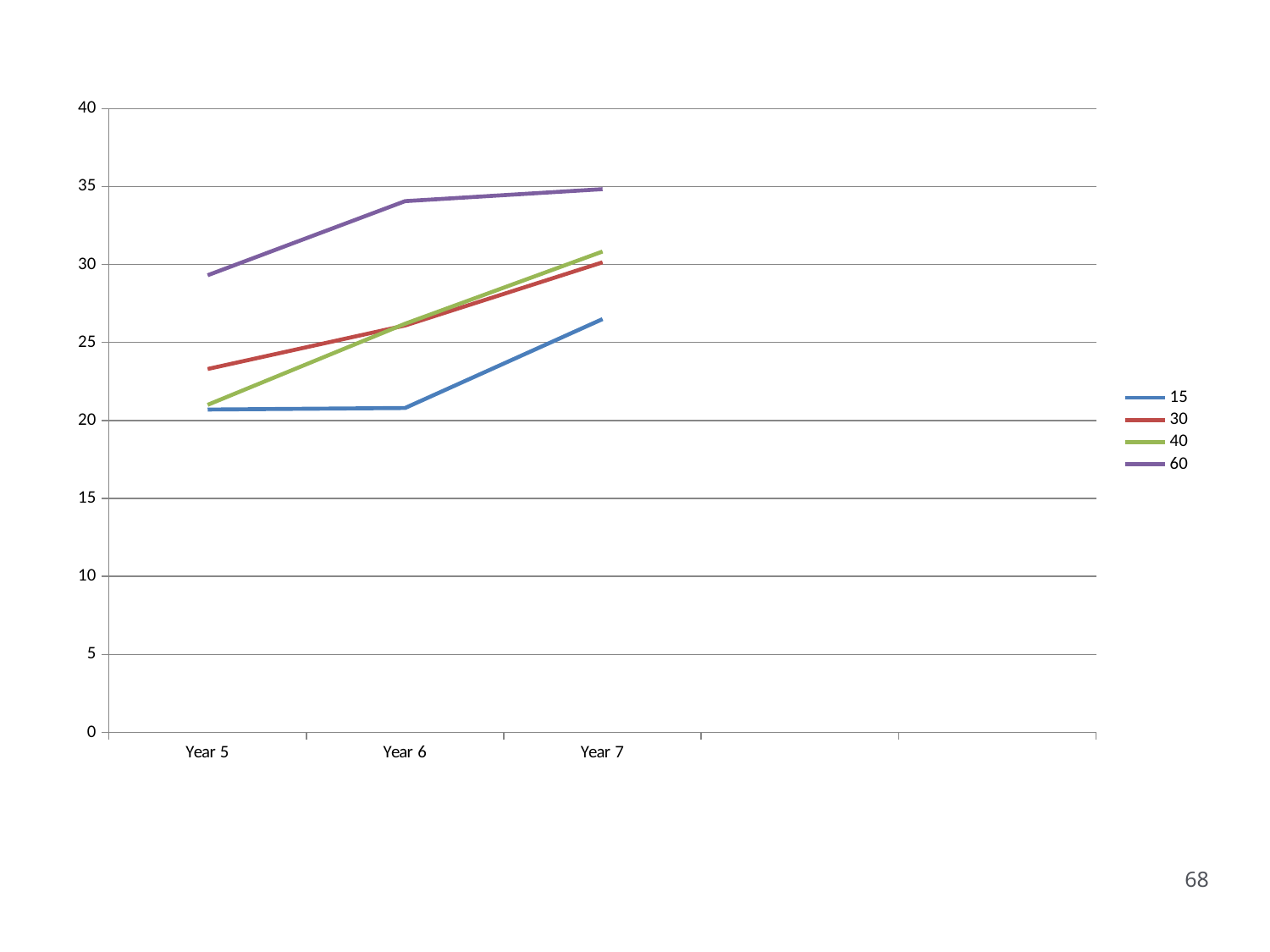
At Year 5, which is larger: the value for series 60 or series 30? 60 Is the value for series 40 at Year 5 greater or less than 25? less At Year 7, which is larger: the value for series 30 or series 15? 30 Which series has the highest value at Year 7? 60 How many categories are labelled on the x axis? 3 How many series does the legend list? 4 What kind of chart is shown on the slide? line chart Is the value for series 15 at Year 5 greater or less than 25? less What are the entries listed in the legend? 15, 30, 40, 60 Which series has the lowest value at Year 7? 15 Is the value for series 60 at Year 6 greater or less than 30? greater Does the value for series 60 rise or fall from Year 5 to Year 7? rise